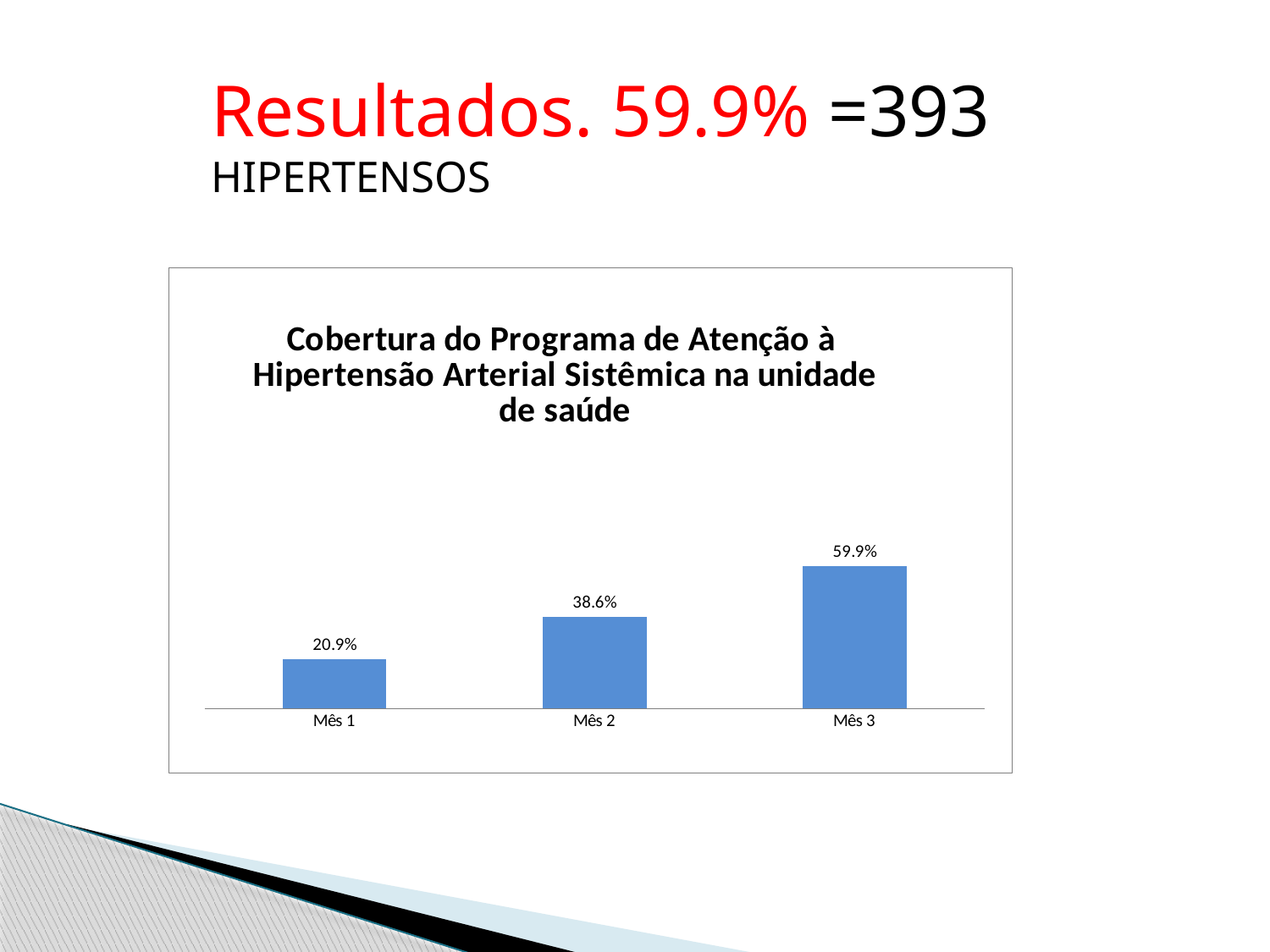
Which month has the lowest value? Mês 1 What is the title of the chart? Cobertura do Programa de Atenção à Hipertensão Arterial Sistêmica na unidade de saúde Which is larger, the value for Mês 2 or the value for Mês 3? Mês 3 What is the value for Mês 2? 38.6% Which month has the highest value? Mês 3 Do the values rise or fall from Mês 1 to Mês 3? Rise What is the value for Mês 3? 59.9% What is the difference between the values for Mês 2 and Mês 1? 17.7% What is the difference between the values for Mês 3 and Mês 1? 39.0% What is the value for Mês 1? 20.9% How many categories are shown on the x axis? 3 What kind of chart is shown? Bar chart